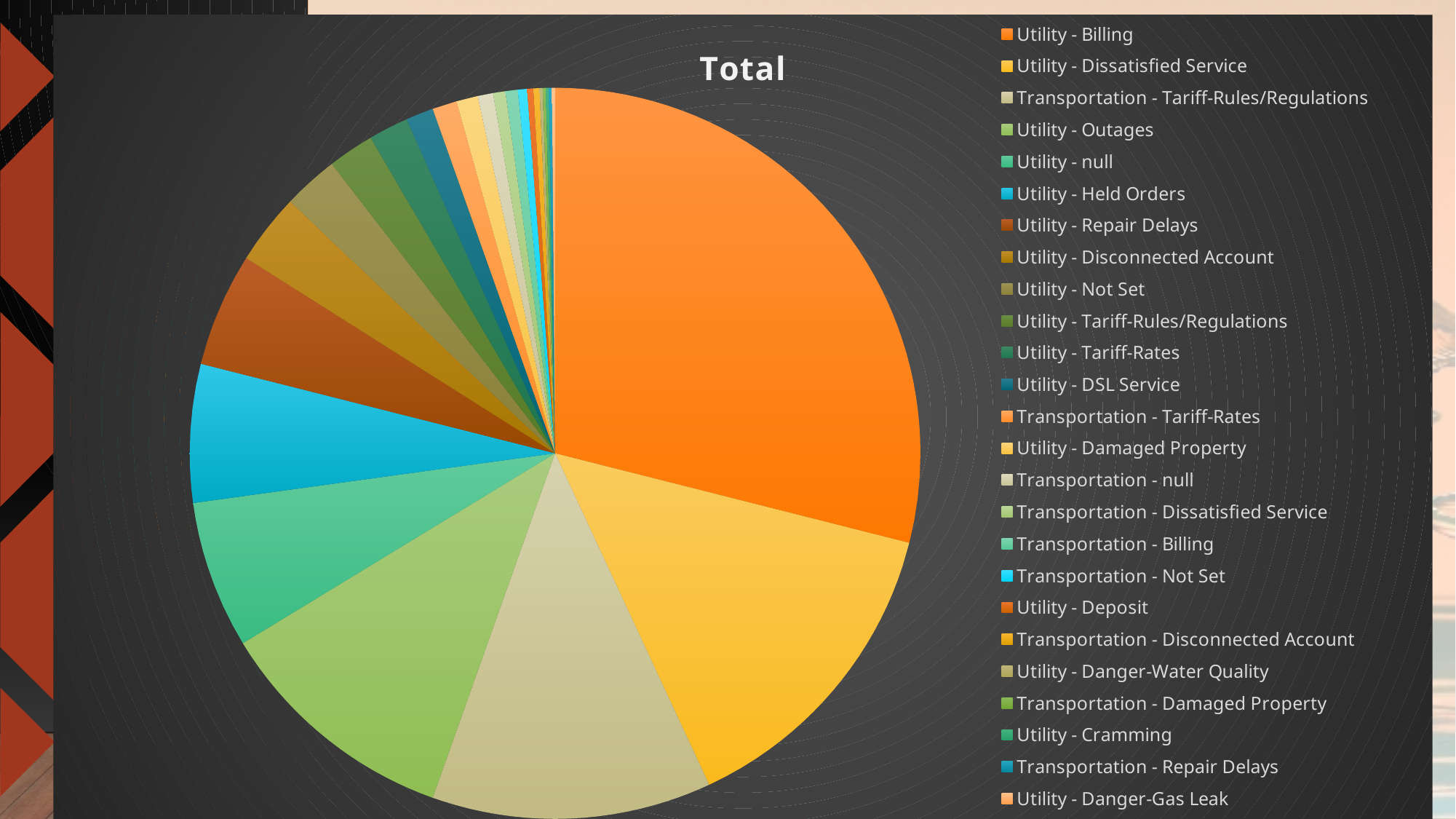
Which slice is larger, Utility - Dissatisfied Service or Utility - Held Orders? Utility - Dissatisfied Service Which slice is larger, Utility - Billing or Utility - Dissatisfied Service? Utility - Billing What kind of chart is shown on the slide? pie chart Which slice is larger, Utility - Outages or Utility - Disconnected Account? Utility - Outages What is the title of the chart? Total Does the Utility - Held Orders slice take up more or less than a quarter of the pie? less Which category has the largest slice of the pie? Utility - Billing Which category is listed first in the legend? Utility - Billing Does the Utility - Billing slice take up more or less than half of the pie? less